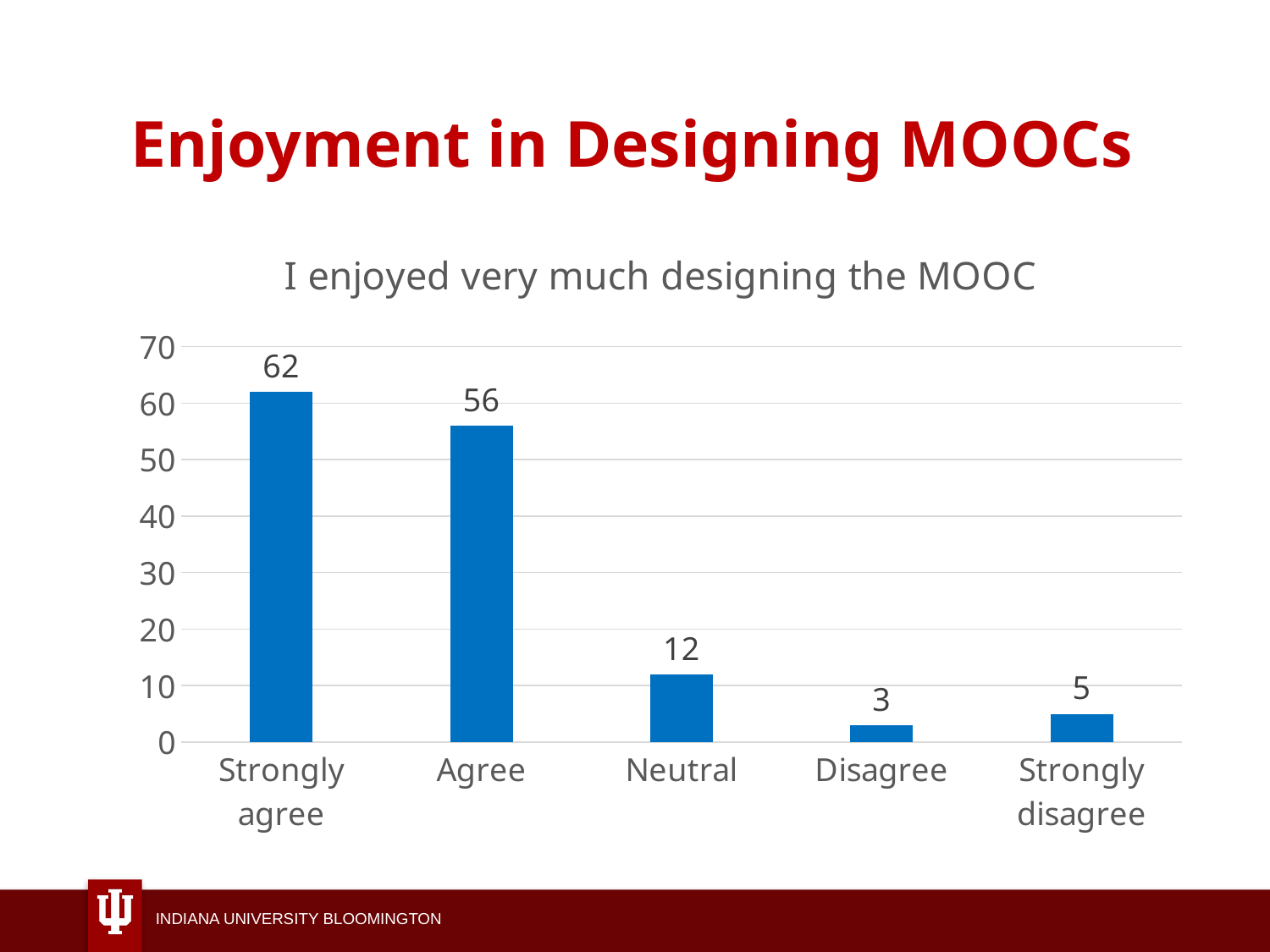
What is the value for Disagree? 3 Is the value for Agree greater or less than 50? greater What is the difference between the values for Strongly agree and Agree? 6 How many categories are shown on the x axis? 5 What is the title of the chart? I enjoyed very much designing the MOOC What is the difference between the values for Neutral and Strongly disagree? 7 What is the value for Neutral? 12 Which category has the lowest value? Disagree What is the value for Strongly agree? 62 What kind of chart is shown on the slide? bar chart Which is larger, the value for Agree or the value for Neutral? Agree Which category has the highest value? Strongly agree